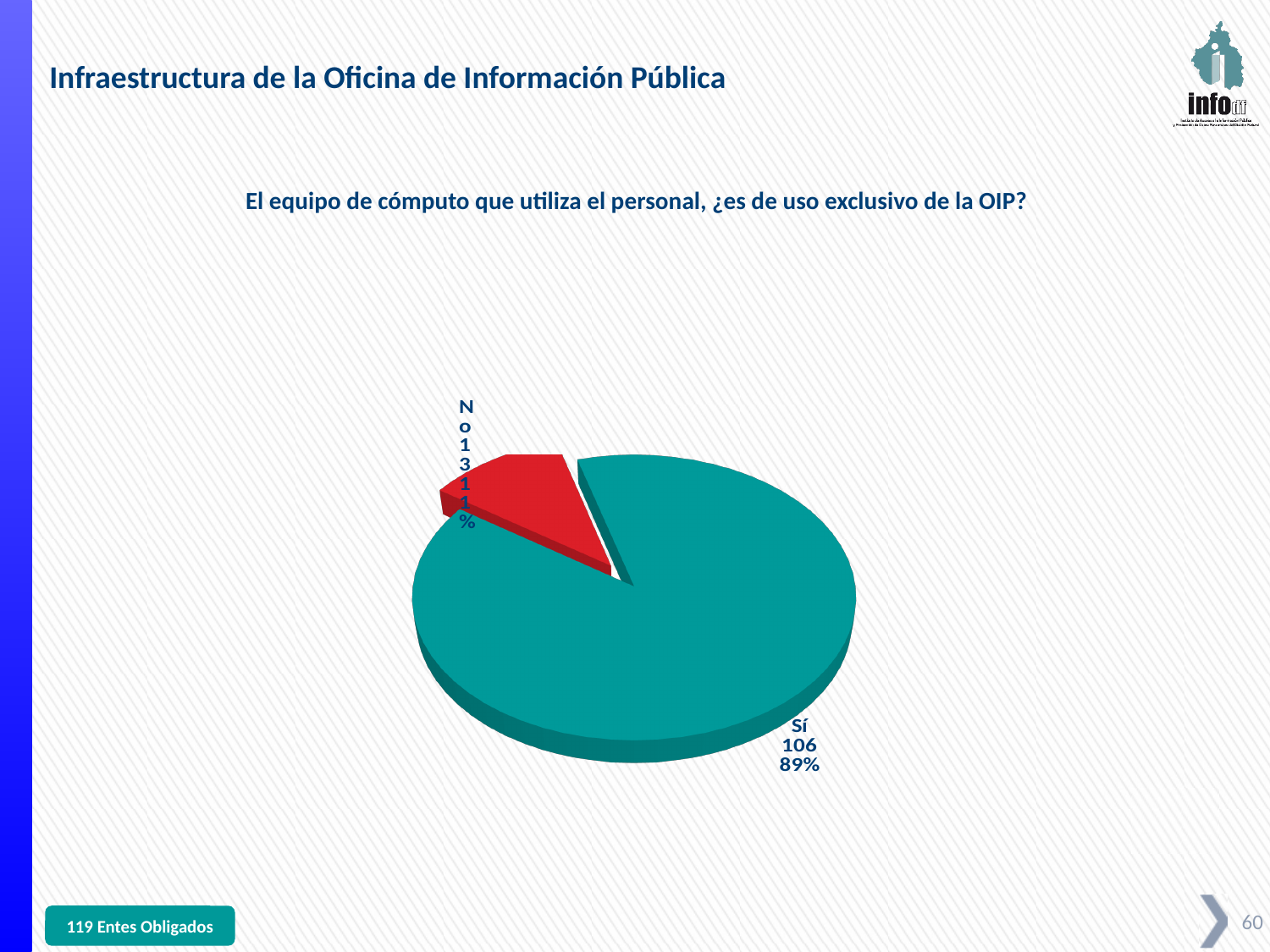
How many slices does the pie chart have? 2 What is the count for the "Sí" slice? 106 What kind of chart is shown on the slide? pie chart Which slice is the largest in the pie chart? Sí What percentage does the "No" slice represent? 11% What is the count for the "No" slice? 13 Which is larger, the "Sí" slice or the "No" slice? Sí What percentage does the "Sí" slice represent? 89% Which slice is the smallest in the pie chart? No What is the difference between the counts for "Sí" and "No"? 93 What colour is the "No" slice of the pie chart? red What is the total of the counts shown in the pie chart? 119